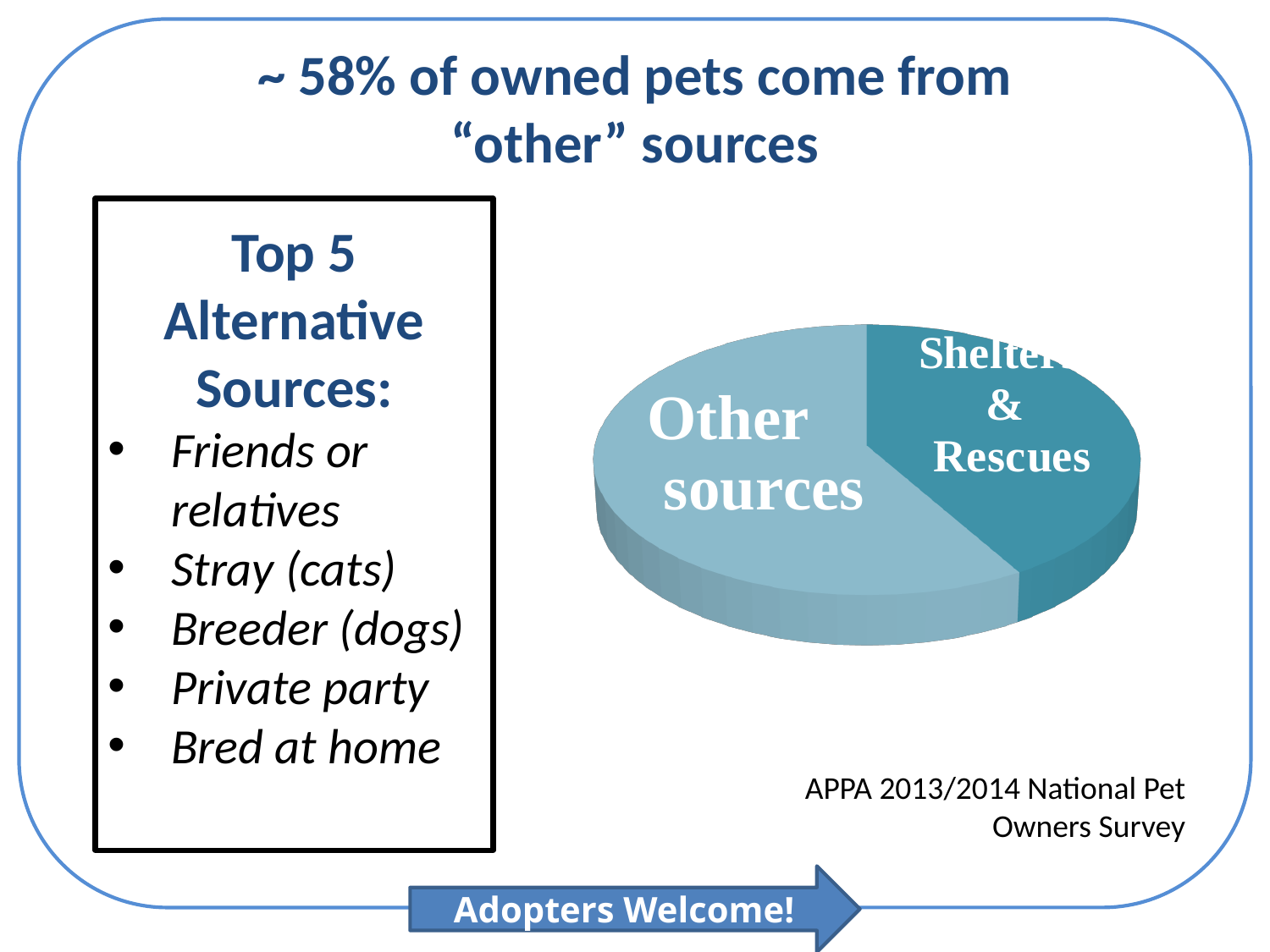
Which slice of the pie chart is the smallest? Shelters & Rescues Is the share of the Other sources slice greater or less than half of the pie? greater How many slices does the pie chart have? 2 What kind of chart is shown on the slide? pie chart Which is larger in the pie chart, Other sources or Shelters & Rescues? Other sources Which slice of the pie chart is the largest? Other sources What are the labels of the two slices in the pie chart? Other sources; Shelters & Rescues What data source is cited for the pie chart? APPA 2013/2014 National Pet Owners Survey Is the share of the Shelters & Rescues slice greater or less than half of the pie? less